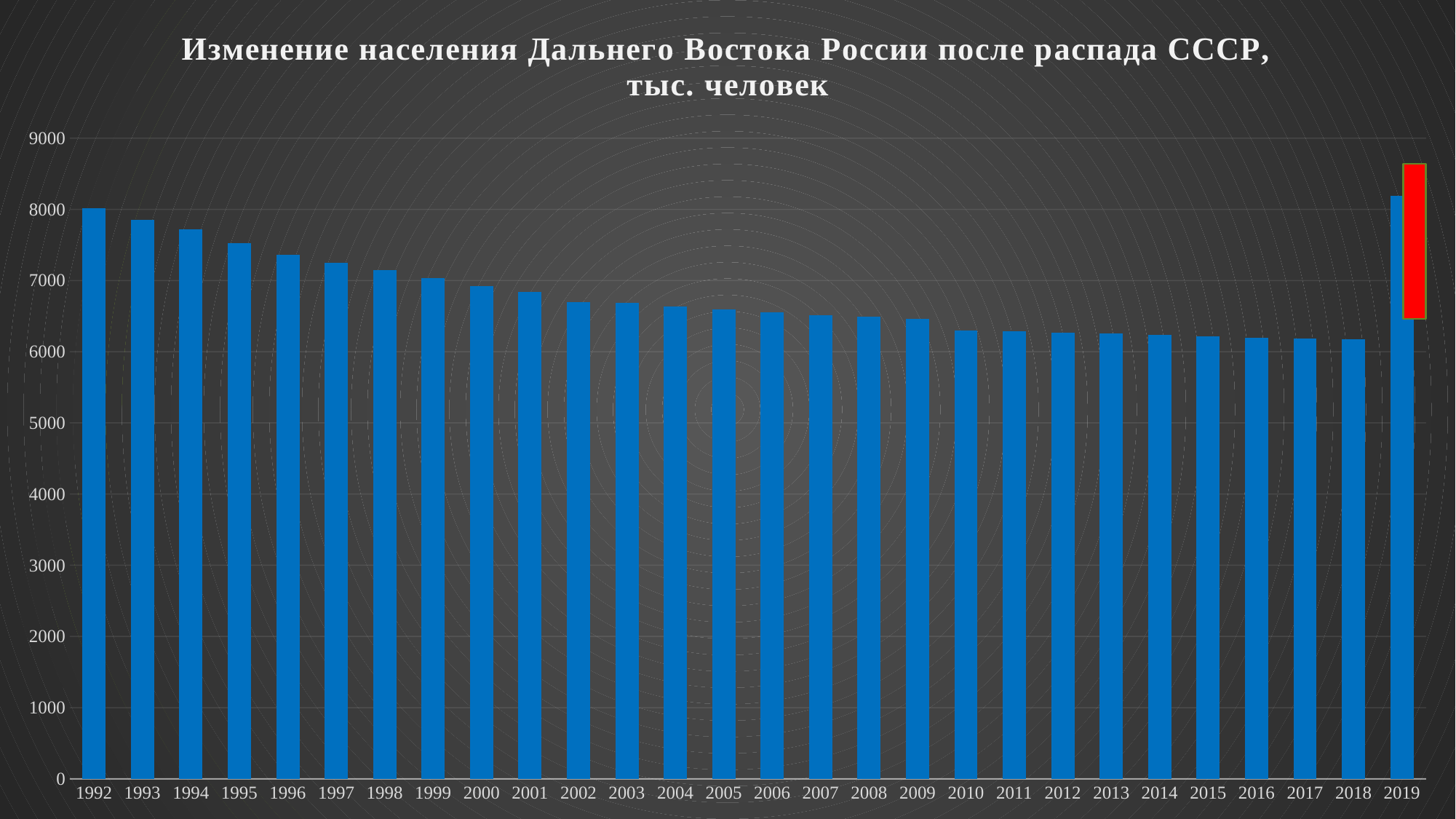
What is the last year shown on the x axis? 2019 Is the value for 2018 greater or less than 7000? less What is the first year shown on the x axis? 1992 Is the value for 1992 greater or less than 7000? greater Which is larger, the value for 1992 or the value for 2010? 1992 Do the values generally rise or fall from 1992 to 2018? fall Is the value for 2019 greater or less than 8000? greater Which is larger, the value for 2005 or the value for 1995? 1995 What kind of chart is shown on the slide? bar chart How many years are shown on the x axis of the chart? 28